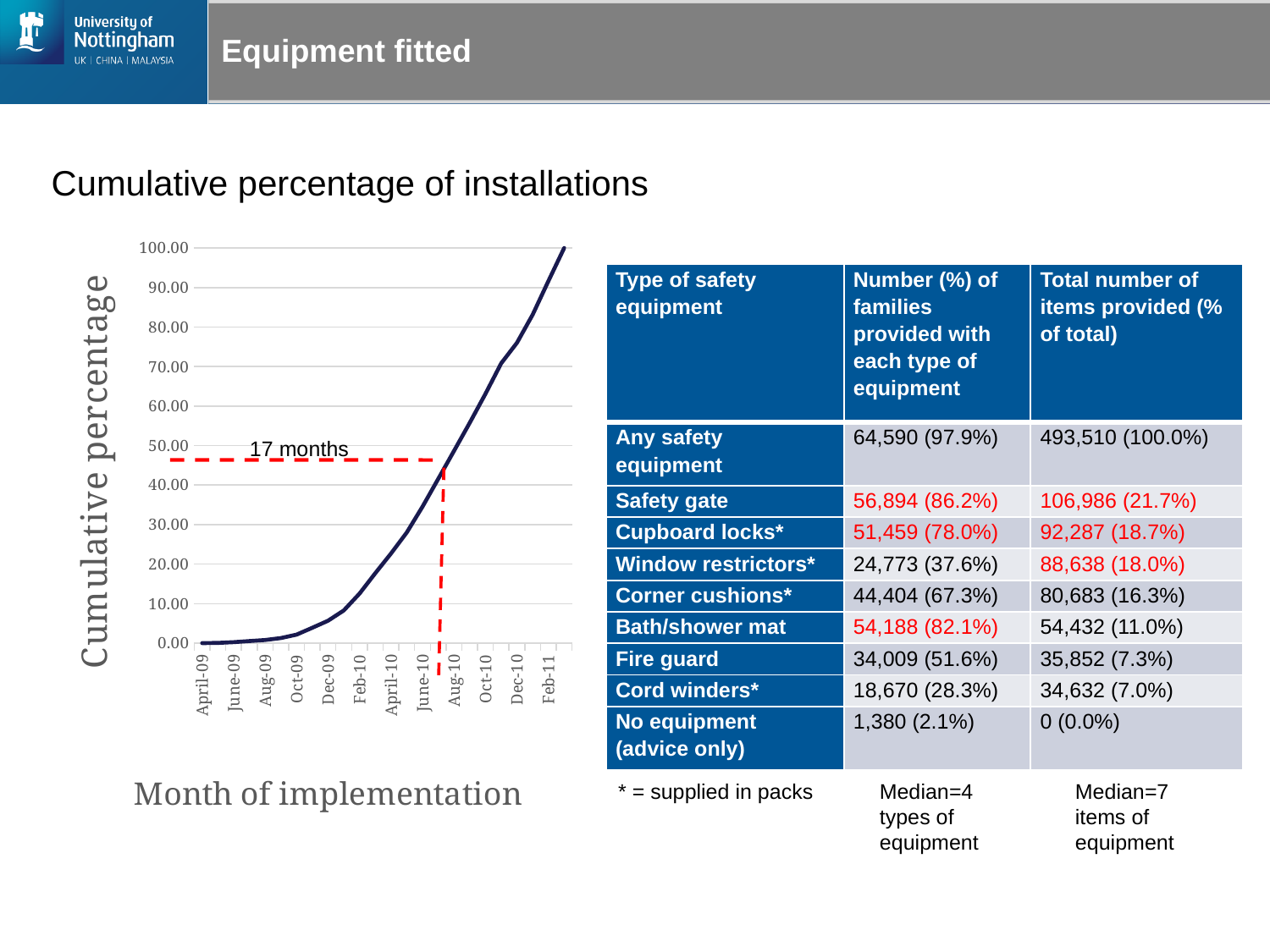
Which is larger, the cumulative percentage at Dec-10 or at June-10? Dec-10 Is the cumulative percentage at Feb-10 greater or less than 10? greater Which month has the lowest cumulative percentage on the chart? April-09 Is the cumulative percentage at Oct-10 greater or less than 50? greater What kind of chart is shown on the slide? line chart Is the cumulative percentage at Dec-10 greater or less than 70? greater Do the values on the chart rise or fall from April-09 to Feb-11? rise What duration is written in the annotation next to the dashed line on the chart? 17 months What is the title of the chart's vertical axis? Cumulative percentage